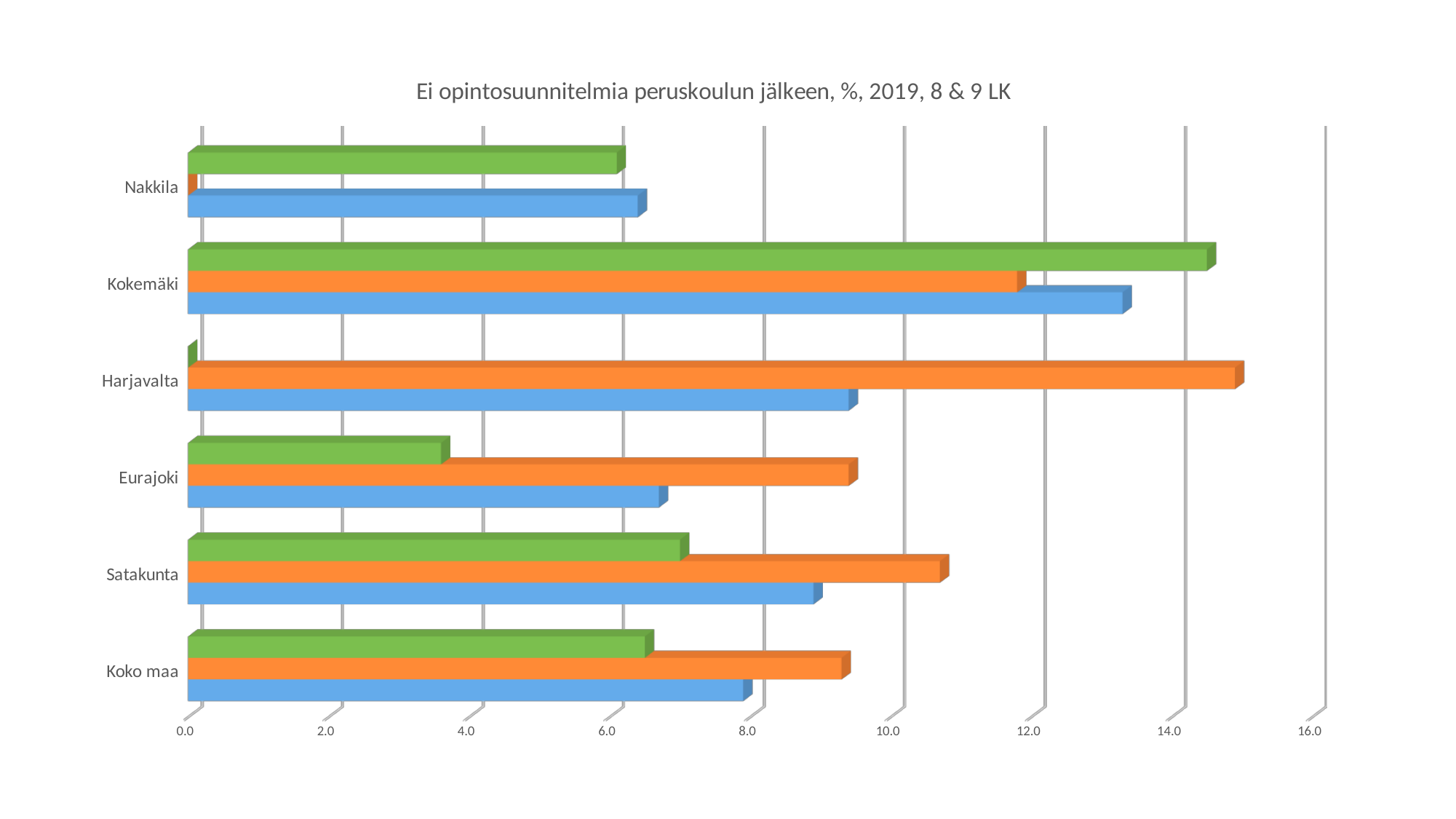
What kind of chart is shown on the slide? bar chart What is the title of the chart? Ei opintosuunnitelmia peruskoulun jälkeen, %, 2019, 8 & 9 LK Is the orange bar for Harjavalta greater or less than 14.0? greater Which category has the longest orange bar? Harjavalta How many categories are shown on the vertical axis of the chart? 6 For Eurajoki, which is larger: the orange bar or the green bar? the orange bar Which category has the shortest green bar? Harjavalta Is the green bar for Eurajoki greater or less than 4.0? less How many bars are plotted for each category in the chart? 3 Is the orange bar for Satakunta greater or less than 10.0? greater Which category has the longest green bar? Kokemäki For Harjavalta, which is larger: the orange bar or the blue bar? the orange bar